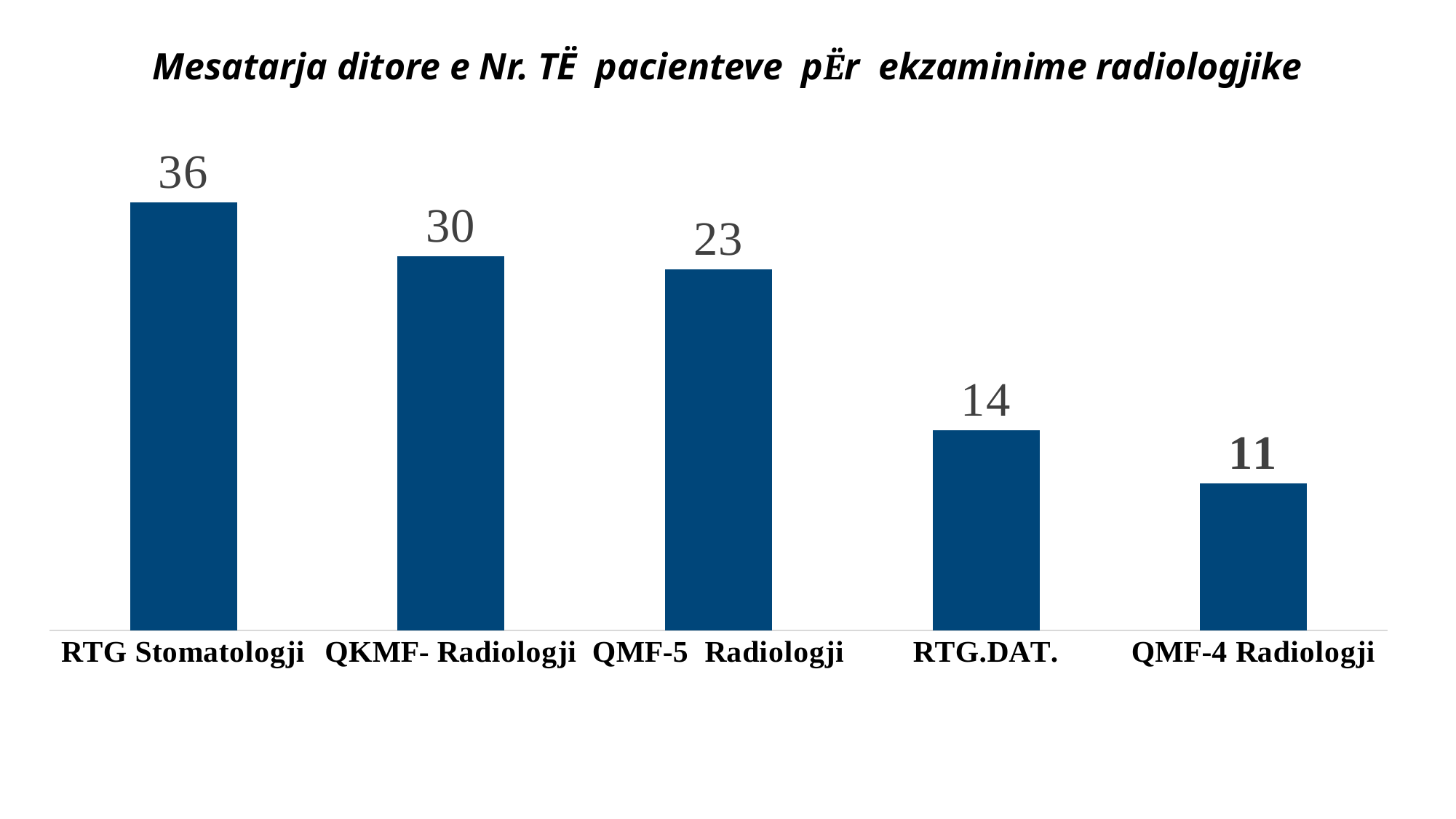
Do the values rise or fall from left to right across the categories? Fall How many categories are shown in the chart? 5 What is the value for QKMF- Radiologji? 30 What is the value for QMF-4 Radiologji? 11 What kind of chart is shown on the slide? Bar chart Which is larger, the value for QMF-5 Radiologji or the value for RTG.DAT.? QMF-5 Radiologji Which category has the highest value? RTG Stomatologji What is the value for QMF-5 Radiologji? 23 What is the difference between the values for RTG Stomatologji and QMF-4 Radiologji? 25 Which category has the lowest value? QMF-4 Radiologji What is the value for RTG.DAT.? 14 What is the value for RTG Stomatologji? 36